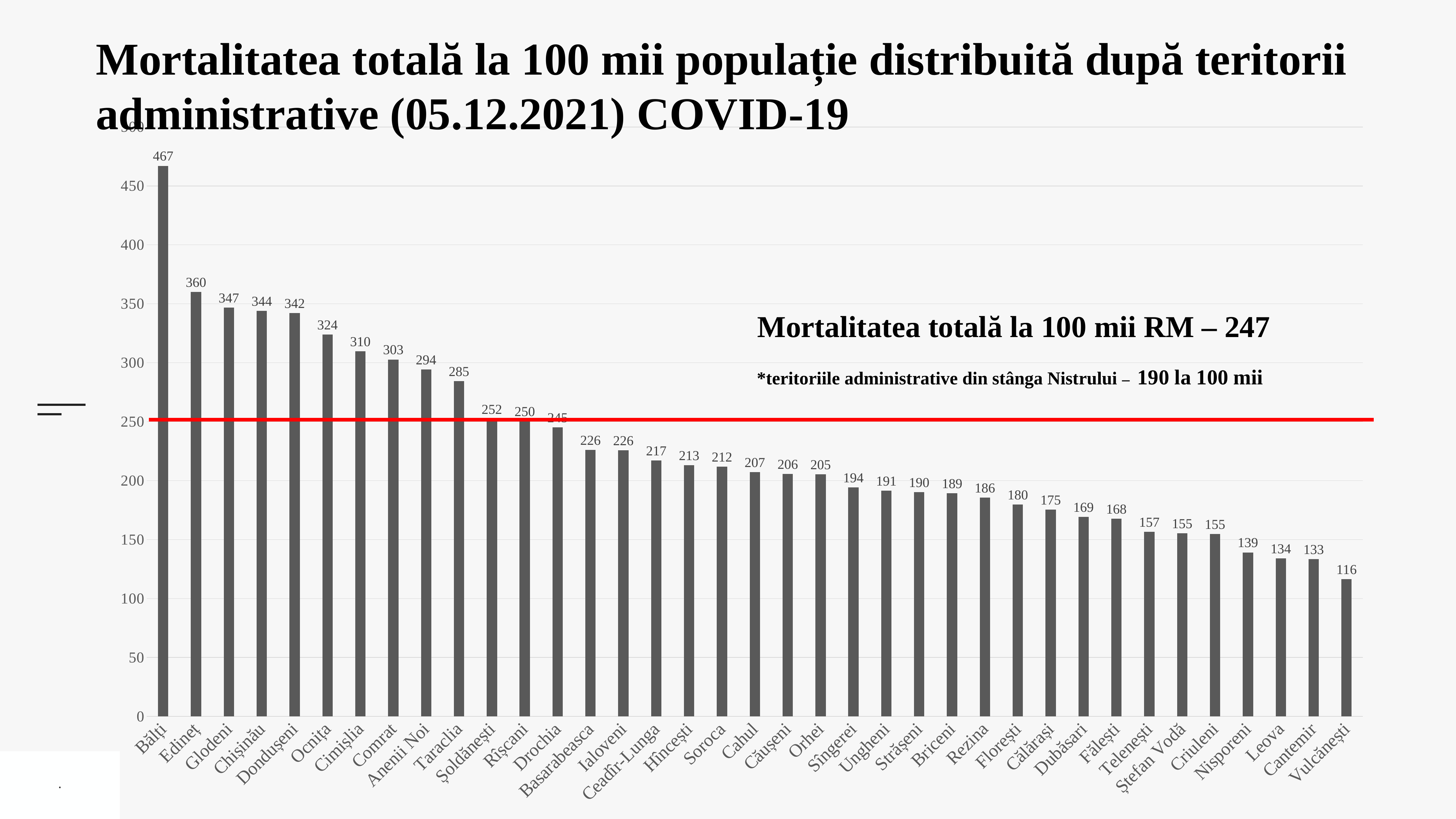
Do the values rise or fall from left to right along the x axis? Fall What is the difference between the values for Bălți and Edineț? 107 Which territory has the lowest value? Vulcănești What value does the text on the slide give for the total mortality per 100 thousand in RM? 247 What is the value for Vulcănești? 116 What kind of chart is shown on the slide? Bar chart What is the value for Bălți? 467 Which territory has the highest value? Bălți Which has a larger value, Ocnița or Comrat? Ocnița What is the value for Cahul? 207 What is the value for Chișinău? 344 How many territories are shown on the x axis? 37